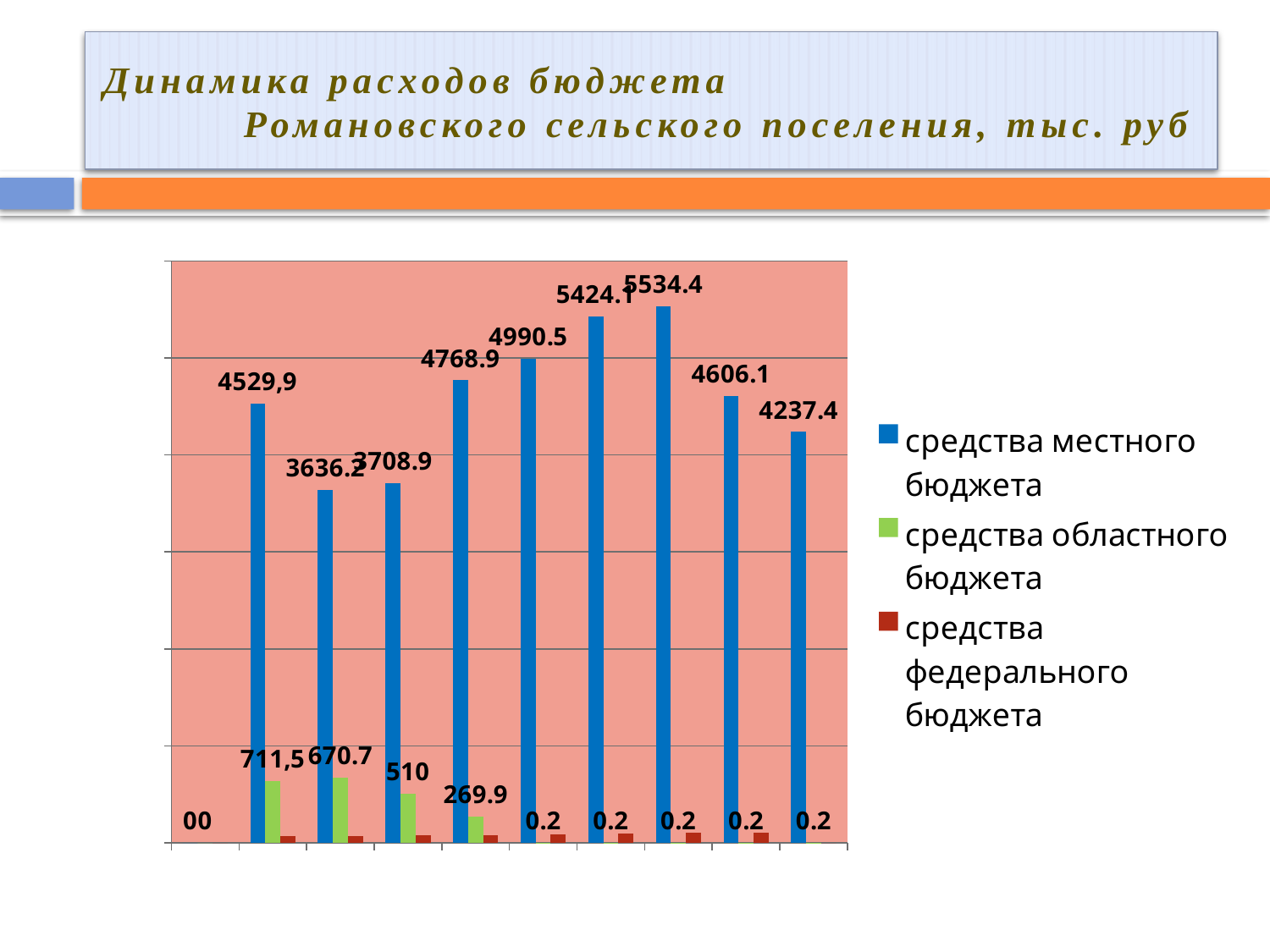
Which is larger for 'средства местного бюджета': the value of the eighth group (4606.1) or the ninth group (4237.4)? 4606.1 (eighth group) Which series is shown in blue in the legend? средства местного бюджета How many series does the legend list? 3 How many groups of bars are plotted along the x axis? 9 What is the highest labelled value for the series 'средства местного бюджета'? 5534.4 What is the value of 'средства местного бюджета' for the last (ninth) group of bars? 4237.4 What is the value of 'средства областного бюджета' for the third group of bars from the left? 510 What is the lowest labelled value for the series 'средства местного бюджета'? 3636.2 What is the value of 'средства областного бюджета' for the first group of bars from the left? 711,5 What is the value of 'средства местного бюджета' for the first group of bars from the left? 4529,9 What is the difference between the 'средства местного бюджета' values of the seventh group (5534.4) and the sixth group (5424.1)? 110.3 What kind of chart is shown on the slide? bar chart